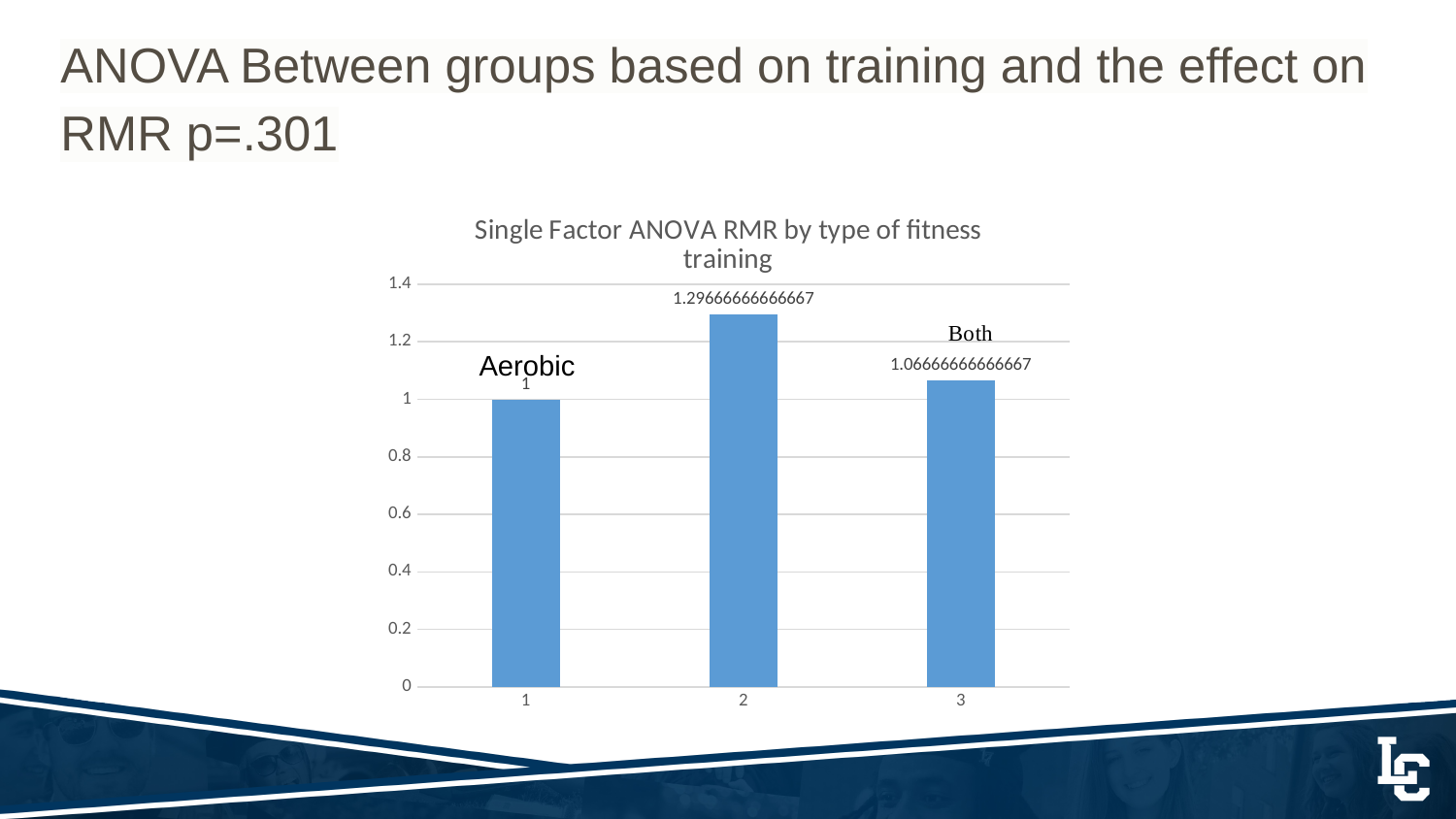
Is the value for category 3 greater or less than 1.2? less What is the value of the bar for category 1? 1 What is the value of the bar for category 2? 1.29666666666667 Which is larger, the value for category 2 or the value for category 3? Category 2 Which category has the lowest value? 1 Is the value for category 2 greater or less than 1.2? greater What is the title of the chart? Single Factor ANOVA RMR by type of fitness training Which category has the highest value? 2 How many bars are plotted in the chart? 3 What kind of chart is shown on the slide? Bar chart What text label is placed above the bar for category 3? Both What is the value of the bar for category 3? 1.06666666666667